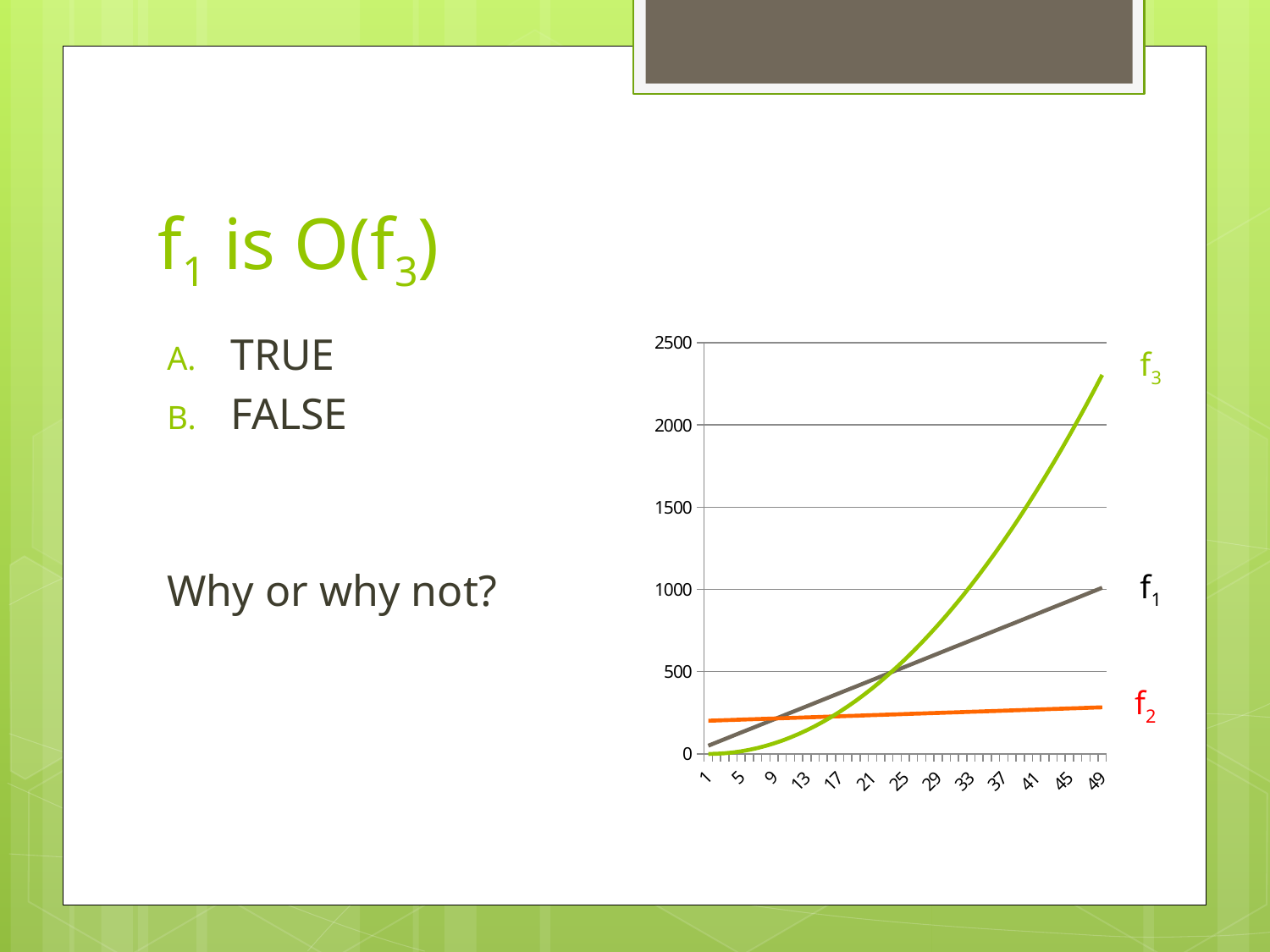
Which series has the lowest value at x = 49? f2 How many series (lines) are plotted on the chart? 3 Is the value of f3 at x = 49 greater or less than 2000? greater What colour is the line for f2? orange Is the value of f2 at x = 49 greater or less than 500? less What kind of chart is shown on the slide? line chart At x = 1, which is larger, f2 or f3? f2 How many labelled tick marks are on the x axis? 13 Which series has the highest value at x = 49? f3 At x = 49, which is larger, f3 or f1? f3 Does f3 rise or fall as x increases along the x axis? rise Is the value of f1 at x = 49 greater or less than 500? greater